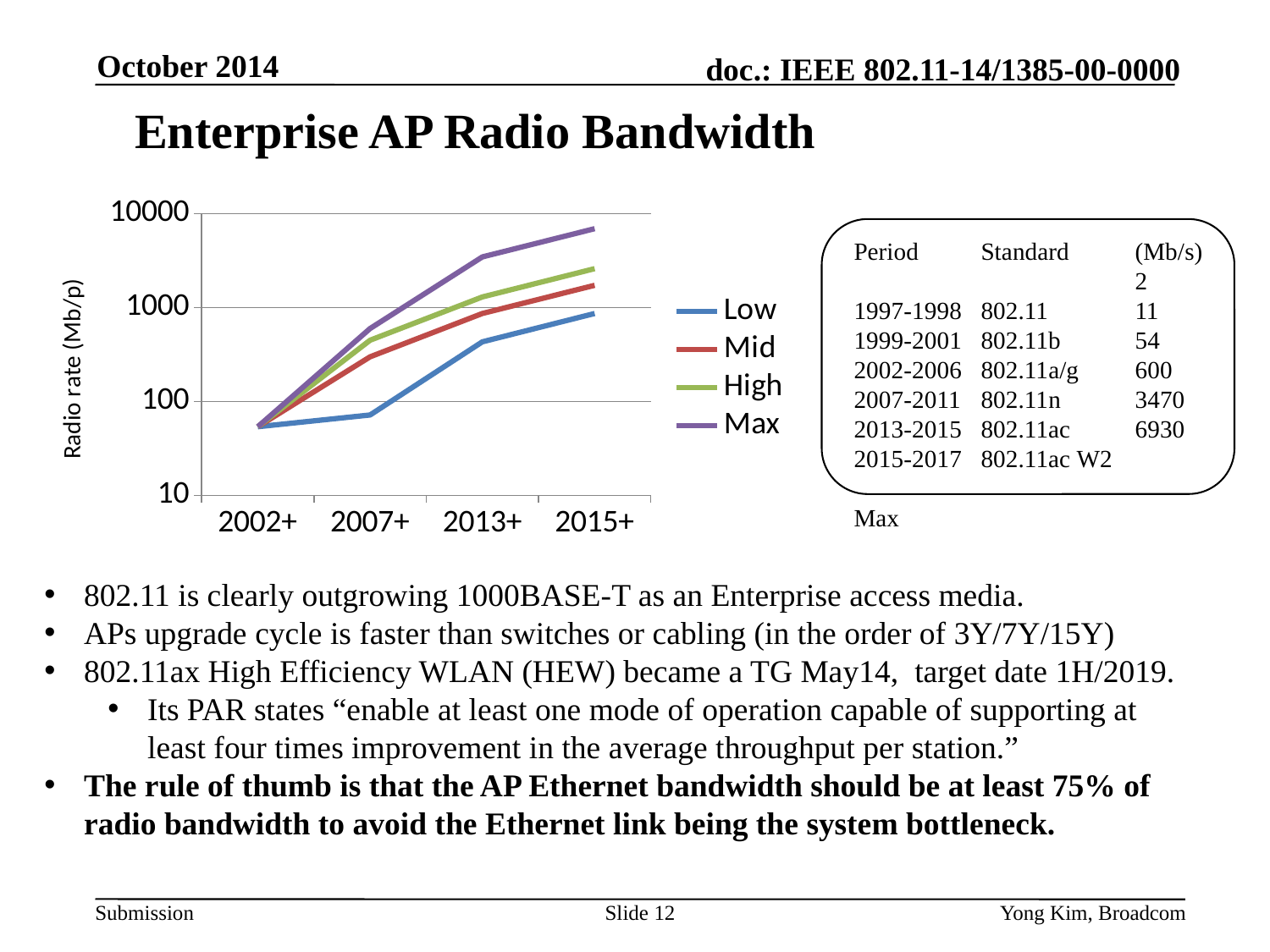
At 2007+, which is larger: the High series or the Low series? High Which series has the lowest value at 2013+? Low What is the label of the y axis of the chart? Radio rate (Mb/p) How many series does the chart legend list? 4 Is the value for the High series at 2015+ greater or less than 1000? greater Is the value for the Low series at 2013+ greater or less than 100? greater Does the Low series rise or fall from 2002+ to 2015+? rise Which series has the highest value at 2015+? Max How many categories are shown on the x axis of the chart? 4 What kind of chart is shown on the slide? line chart Is the value for the Max series at 2015+ greater or less than 1000? greater